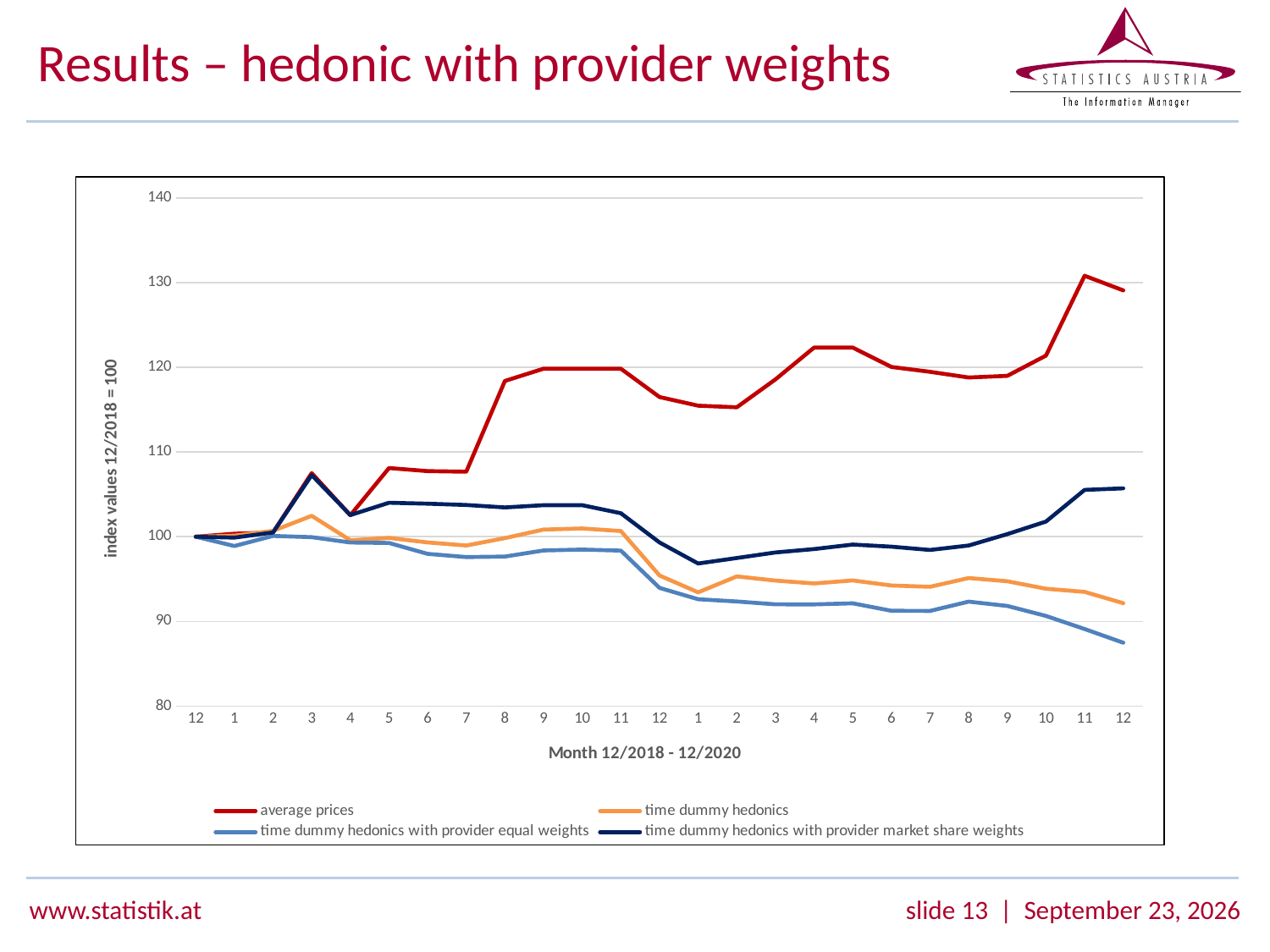
At the final month (12 at the far right), is the value for time dummy hedonics with provider market share weights greater or less than 100? greater How many series does the legend list? 4 Does the average prices series rise or fall overall from the first month to the last month? rise What is the label on the y axis? index values 12/2018 = 100 At the final month (12 at the far right), is the value for average prices greater or less than 120? greater Which series has the highest value at the final month (12 at the far right)? average prices At the final month (12 at the far right), is the value for time dummy hedonics with provider equal weights greater or less than 90? less Which series has the lowest value at the final month (12 at the far right)? time dummy hedonics with provider equal weights What kind of chart is shown on the slide? line chart At the final month (12 at the far right), which is larger: time dummy hedonics or time dummy hedonics with provider market share weights? time dummy hedonics with provider market share weights How many months (points) are plotted along the x axis? 25